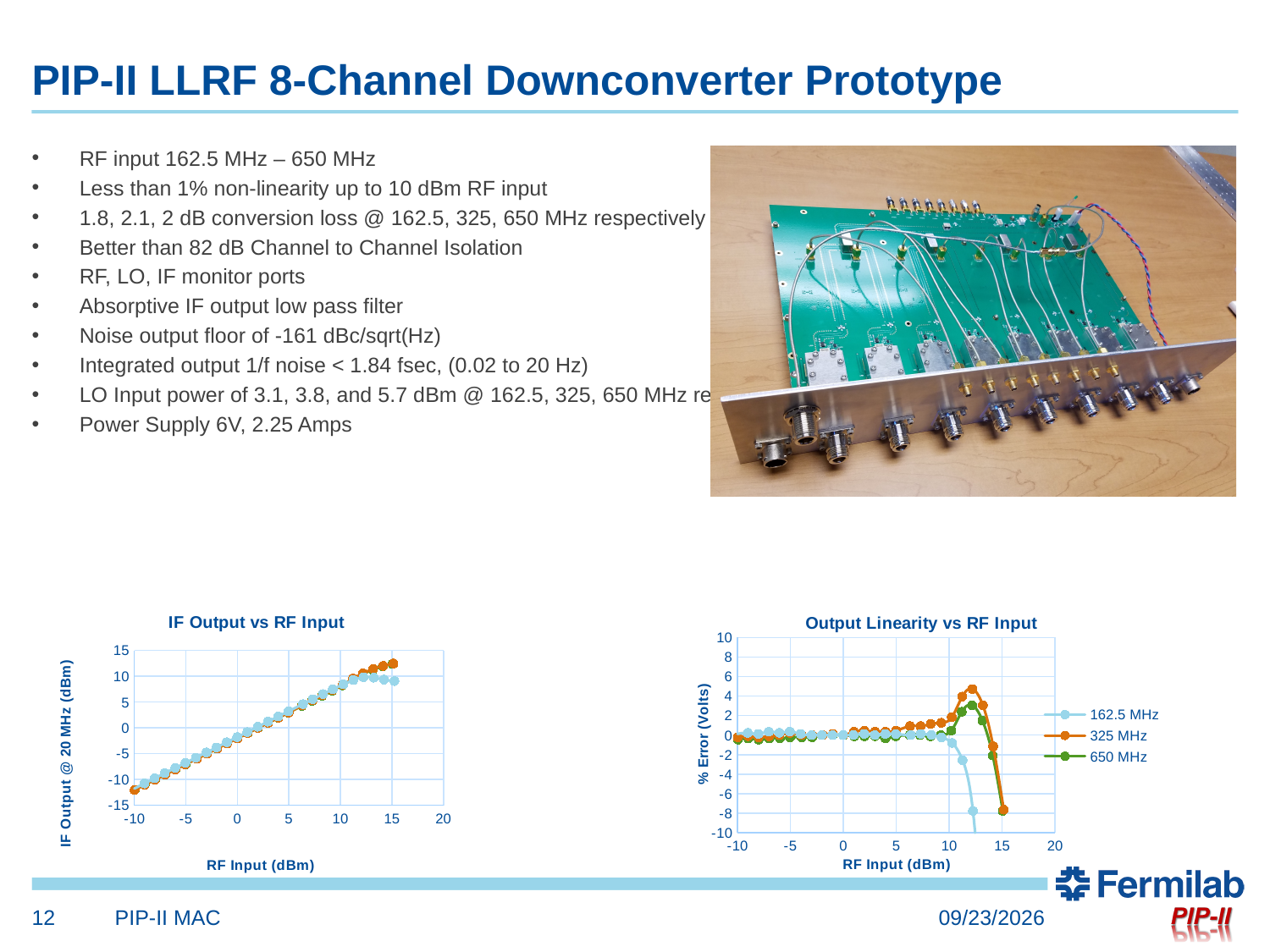
What kind of chart is the 'Output Linearity vs RF Input' chart on the right? line chart How many series does the legend of the 'Output Linearity vs RF Input' chart list? 3 In the 'Output Linearity vs RF Input' chart, is the peak value of the 325 MHz series greater or less than 4? greater In the 'IF Output vs RF Input' chart, does the IF output rise or fall as RF input increases from -10 to 10 dBm? rise In the 'IF Output vs RF Input' chart, is the IF output at an RF input of -10 dBm greater or less than -10? less In the 'Output Linearity vs RF Input' chart, which series reaches the highest % Error? 325 MHz What kind of chart is the 'IF Output vs RF Input' chart on the left? line chart In the 'IF Output vs RF Input' chart, is the IF output at an RF input of 5 dBm greater or less than 10? less What is the y-axis label of the 'Output Linearity vs RF Input' chart? % Error (Volts) What are the legend entries of the 'Output Linearity vs RF Input' chart? 162.5 MHz, 325 MHz, 650 MHz